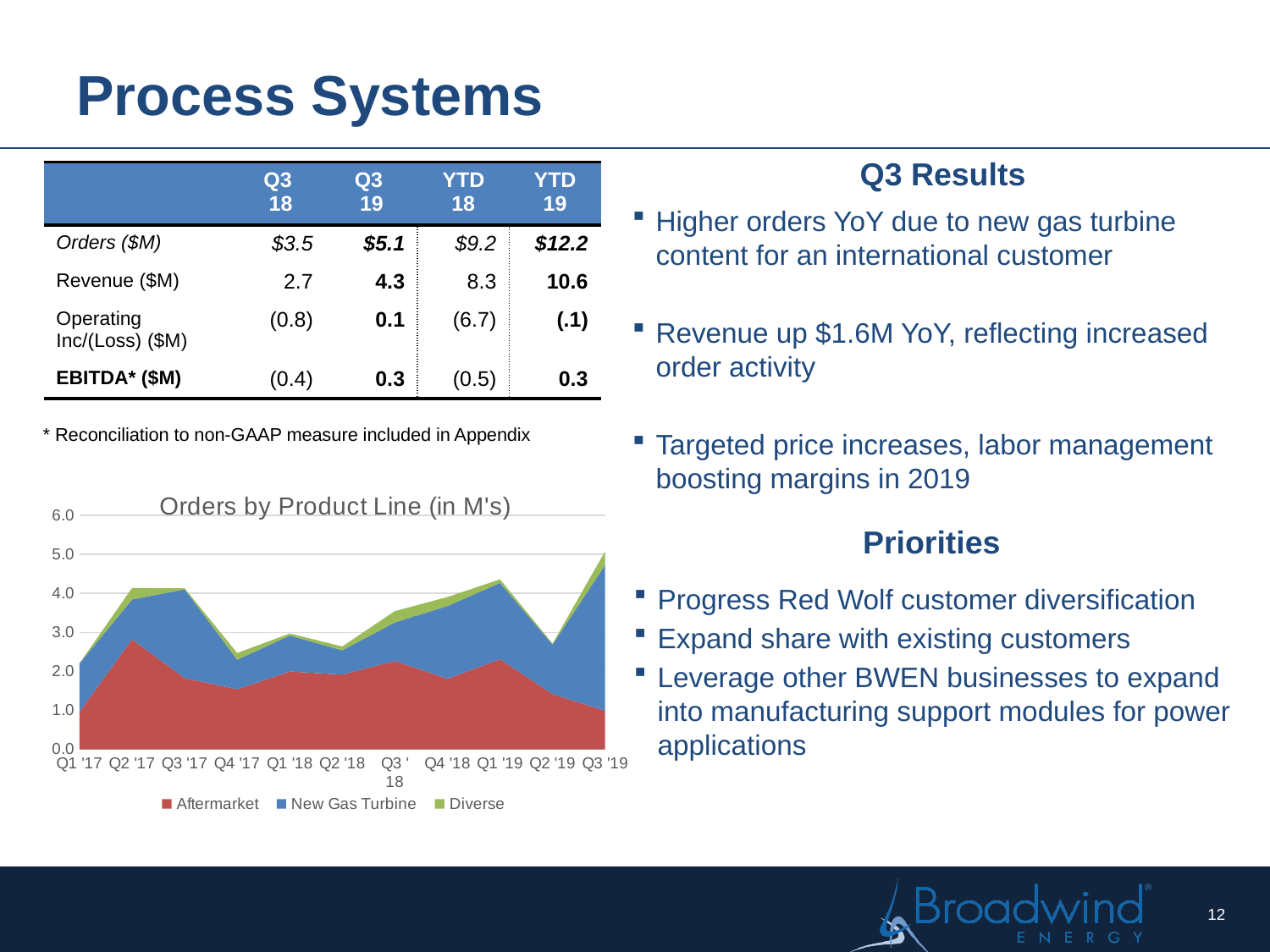
How many quarters are shown on the x axis of the Orders by Product Line chart? 11 In the Orders by Product Line chart, is the total orders value for Q4 '17 greater or less than 3.0? less In the Orders by Product Line chart, is the Aftermarket value for Q2 '17 greater or less than 2.0? greater In the Orders by Product Line chart, which quarter has the highest total orders? Q3 '19 In the Orders by Product Line chart, which quarter has higher total orders, Q2 '19 or Q3 '19? Q3 '19 What kind of chart is "Orders by Product Line (in M's)"? Stacked area chart Which product lines are listed in the legend of the Orders by Product Line chart? Aftermarket, New Gas Turbine, Diverse How many series does the legend of the Orders by Product Line chart list? 3 In the Orders by Product Line chart, do total orders rise or fall from Q1 '19 to Q2 '19? Fall In the Orders by Product Line chart, which colour represents Aftermarket? Red In the Orders by Product Line chart, is the total orders value for Q2 '19 greater or less than 2.0? greater